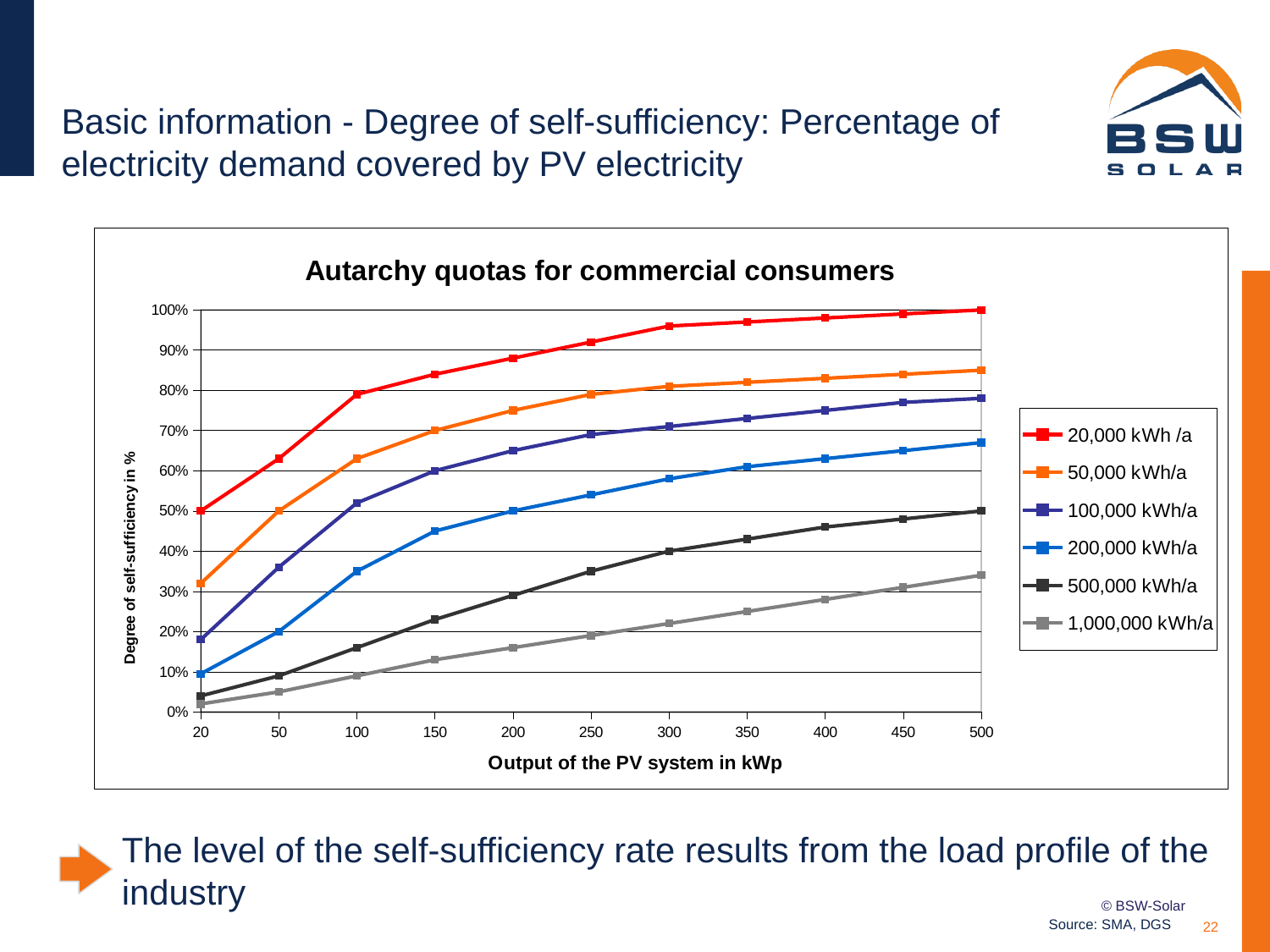
Which series has the highest degree of self-sufficiency at 500 kWp? 20,000 kWh/a Do the values of the 200,000 kWh/a series rise or fall as the PV system output increases? rise What is the degree of self-sufficiency for the 20,000 kWh/a series at 20 kWp? 50% What is the degree of self-sufficiency for the 20,000 kWh/a series at 500 kWp? 100% Is the value for the 100,000 kWh/a series at 500 kWp greater or less than 80%? less How many series does the legend list? 6 Which series has the lowest degree of self-sufficiency across the whole range? 1,000,000 kWh/a What is the title of the chart? Autarchy quotas for commercial consumers What type of chart is shown on the slide? Line chart What is the degree of self-sufficiency for the 500,000 kWh/a series at 500 kWp? 50% How many PV system output values are plotted along the x axis? 11 Is the value for the 1,000,000 kWh/a series at 500 kWp greater or less than 30%? greater